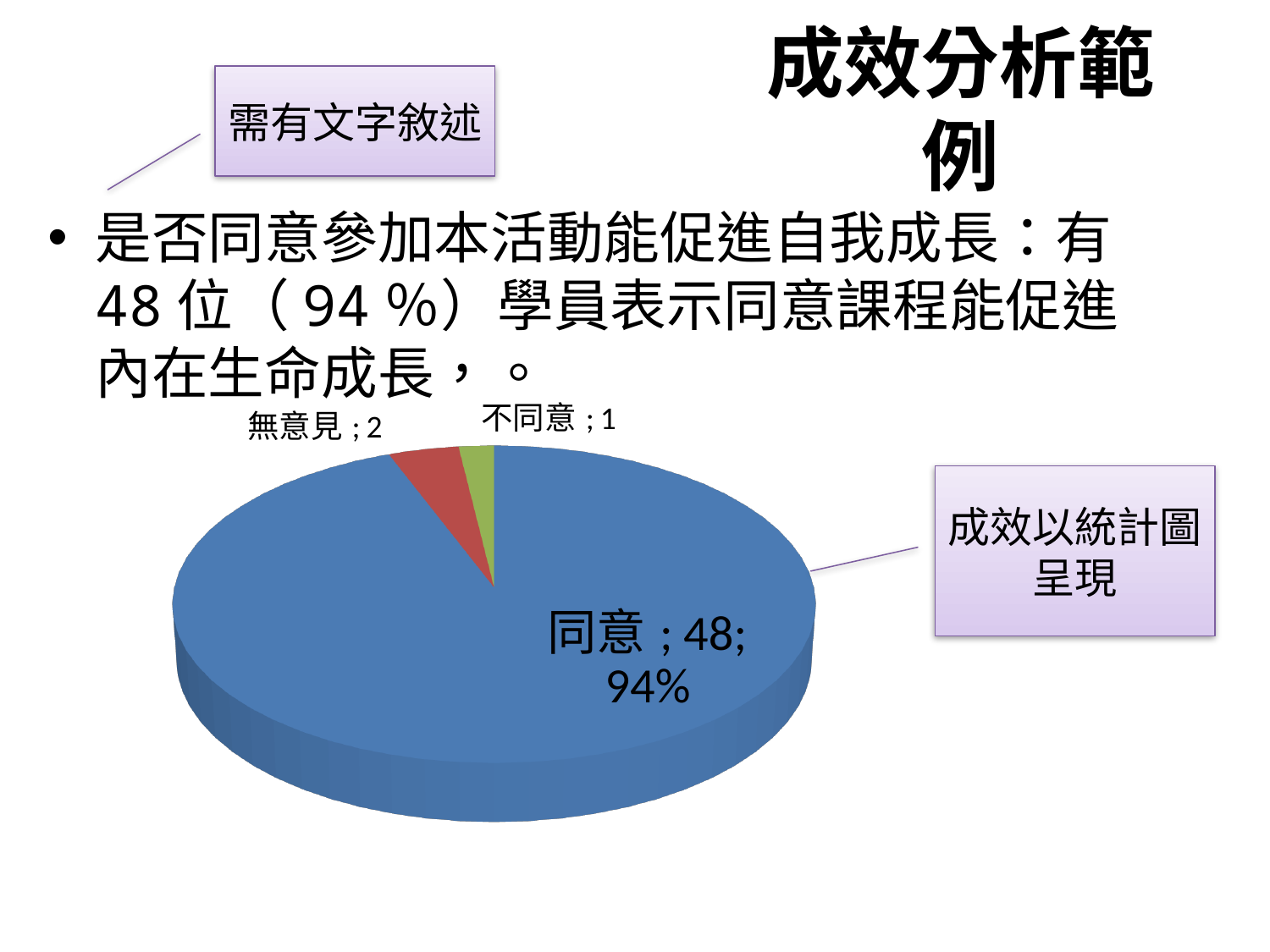
What is the value for 同意 in the pie chart? 48 Which is larger, the value for 無意見 or the value for 不同意? 無意見 What kind of chart is shown on the slide? pie chart What colour is the 同意 slice in the pie chart? blue Which category has the largest slice in the pie chart? 同意 What is the value for 不同意 in the pie chart? 1 What is the difference between the values for 同意 and 無意見? 46 How many slices does the pie chart have? 3 What is the value for 無意見 in the pie chart? 2 What is the difference between the values for 無意見 and 不同意? 1 Which category has the smallest slice in the pie chart? 不同意 What share of the pie does 同意 represent? 94%